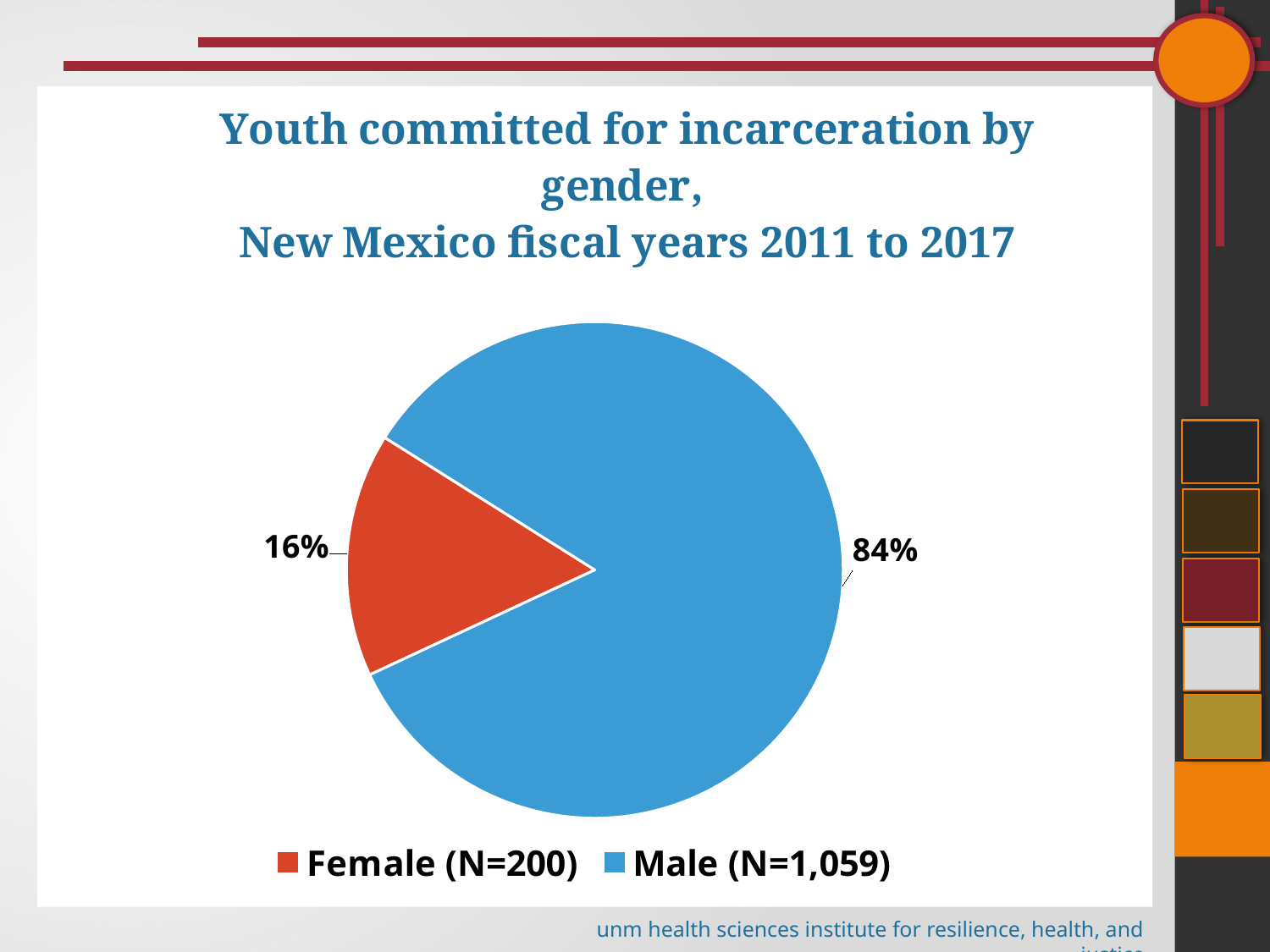
What kind of chart is shown on the slide? pie chart What share of the pie is Female? 16% What is the difference in percentage points between the Male share and the Female share? 68 Which category has the smallest slice of the pie? Female What share of the pie is Male? 84% How many entries does the legend list? 2 What colour is the Female slice of the pie? red Which is larger, the Female share or the Male share? Male What is the N shown in the legend for Female? 200 How many slices does the pie chart have? 2 Which category has the largest slice of the pie? Male What is the N shown in the legend for Male? 1,059